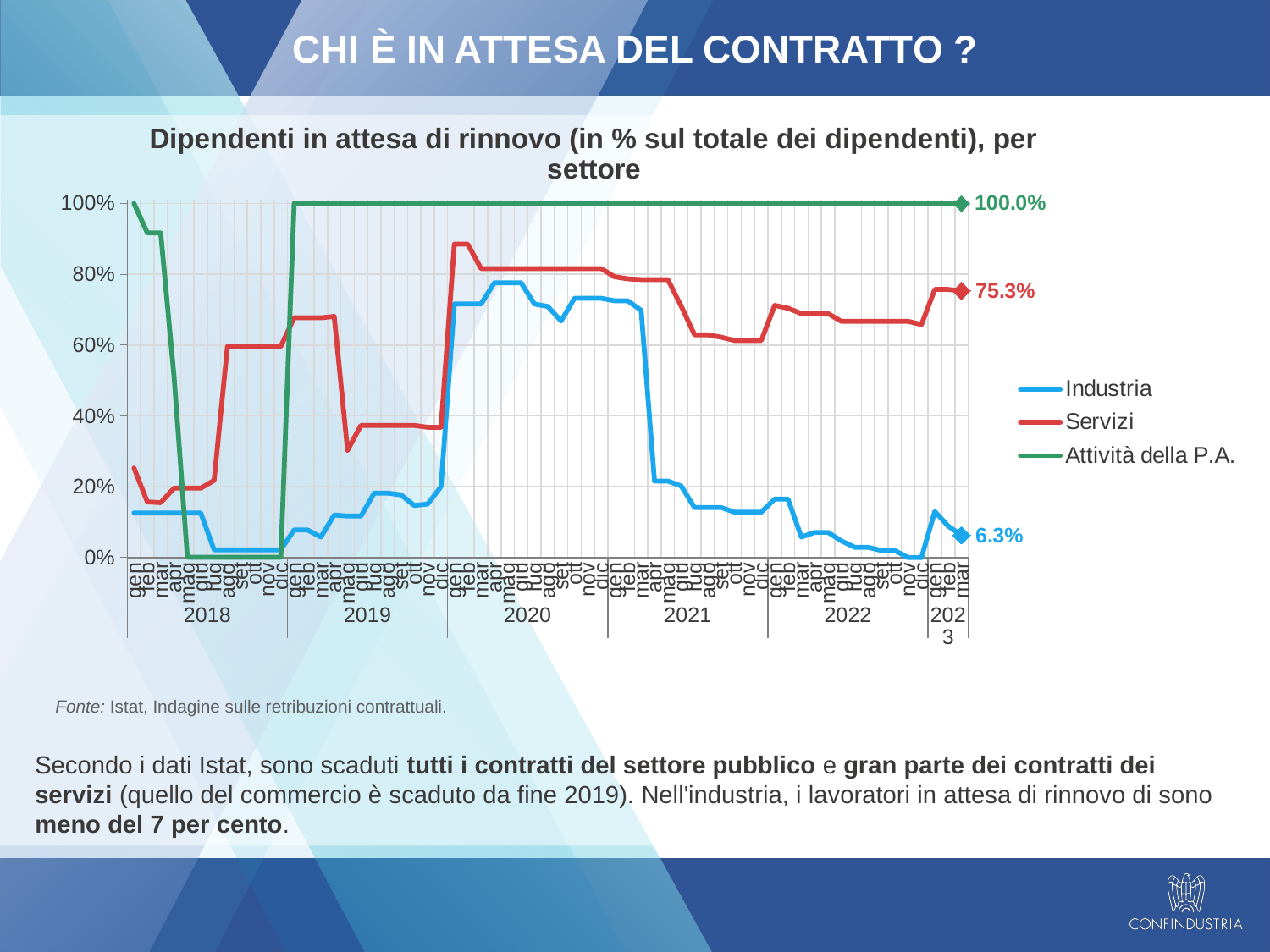
What is the difference between the final labelled values of Attività della P.A. and Servizi? 24.7% What kind of chart is shown on the slide? Line chart What is the data label shown at the end of the Servizi line? 75.3% Which series has the highest value at the end of the chart (mar 2023)? Attività della P.A. What is the data label shown at the end of the Attività della P.A. line? 100.0% Is the value for Servizi in gen 2020 greater or less than 80%? greater What is the data label shown at the end of the Industria line? 6.3% What is the difference between the final labelled values of Servizi and Industria? 69.0% How many series does the legend list? 3 Which series has the lowest value at the end of the chart (mar 2023)? Industria Is the value for Industria in gen 2018 greater or less than 20%? less At the end of the chart, which is larger: the value for Servizi or the value for Industria? Servizi